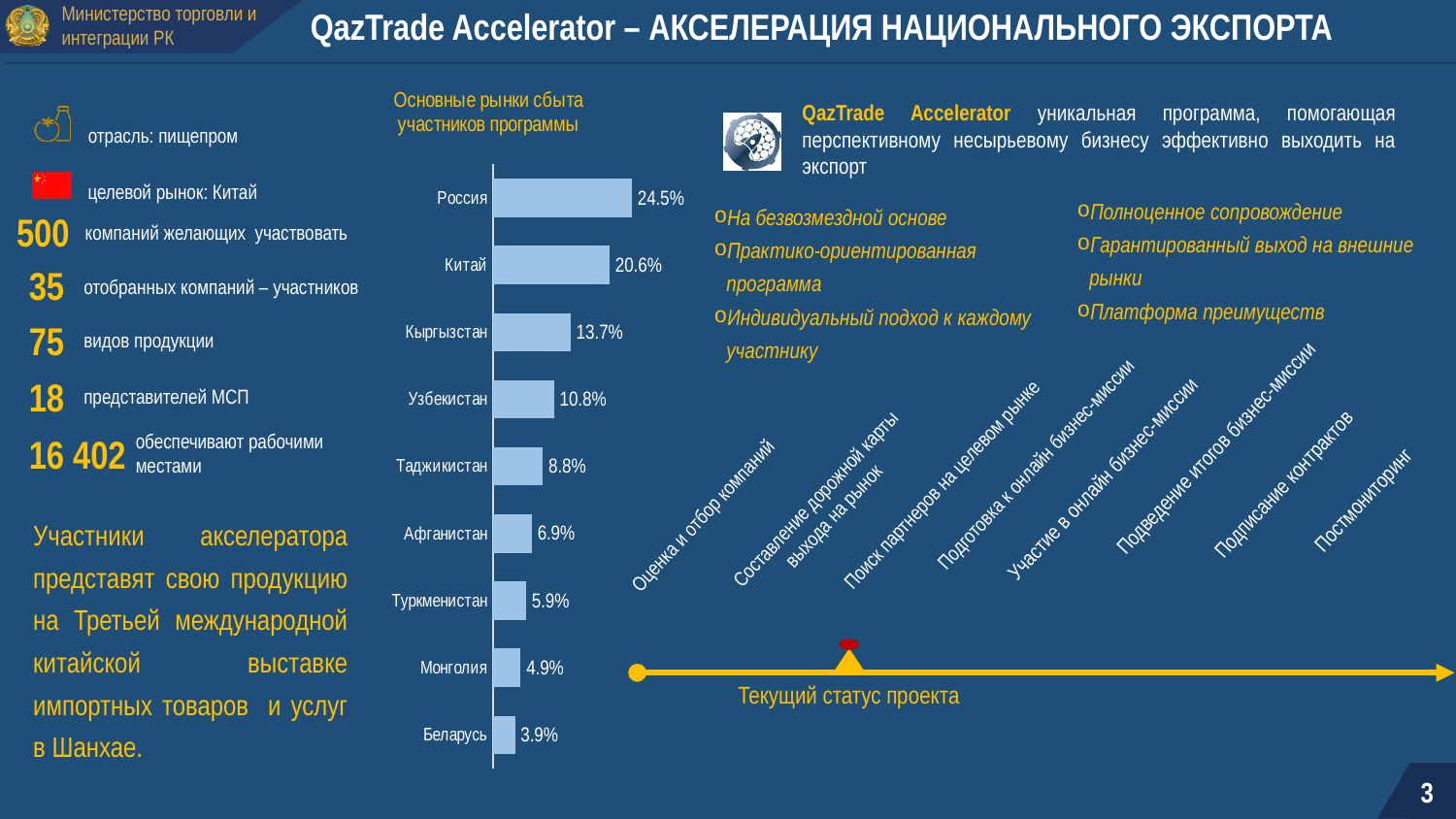
What is the difference between the values for Кыргызстан and Таджикистан? 4.9% What is the value for Монголия in the chart? 4.9% What is the value for Россия in the chart 'Основные рынки сбыта участников программы'? 24.5% How many categories are shown in the chart? 9 Which category has the lowest value in the chart? Беларусь Which is larger, the value for Афганистан or the value for Туркменистан? Афганистан What is the value for Китай in the chart? 20.6% What is the value for Узбекистан in the chart? 10.8% What type of chart is used to show the main sales markets? Bar chart What is the title of the chart on the slide? Основные рынки сбыта участников программы Which category has the highest value in the chart? Россия What is the difference between the values for Россия and Китай? 3.9%